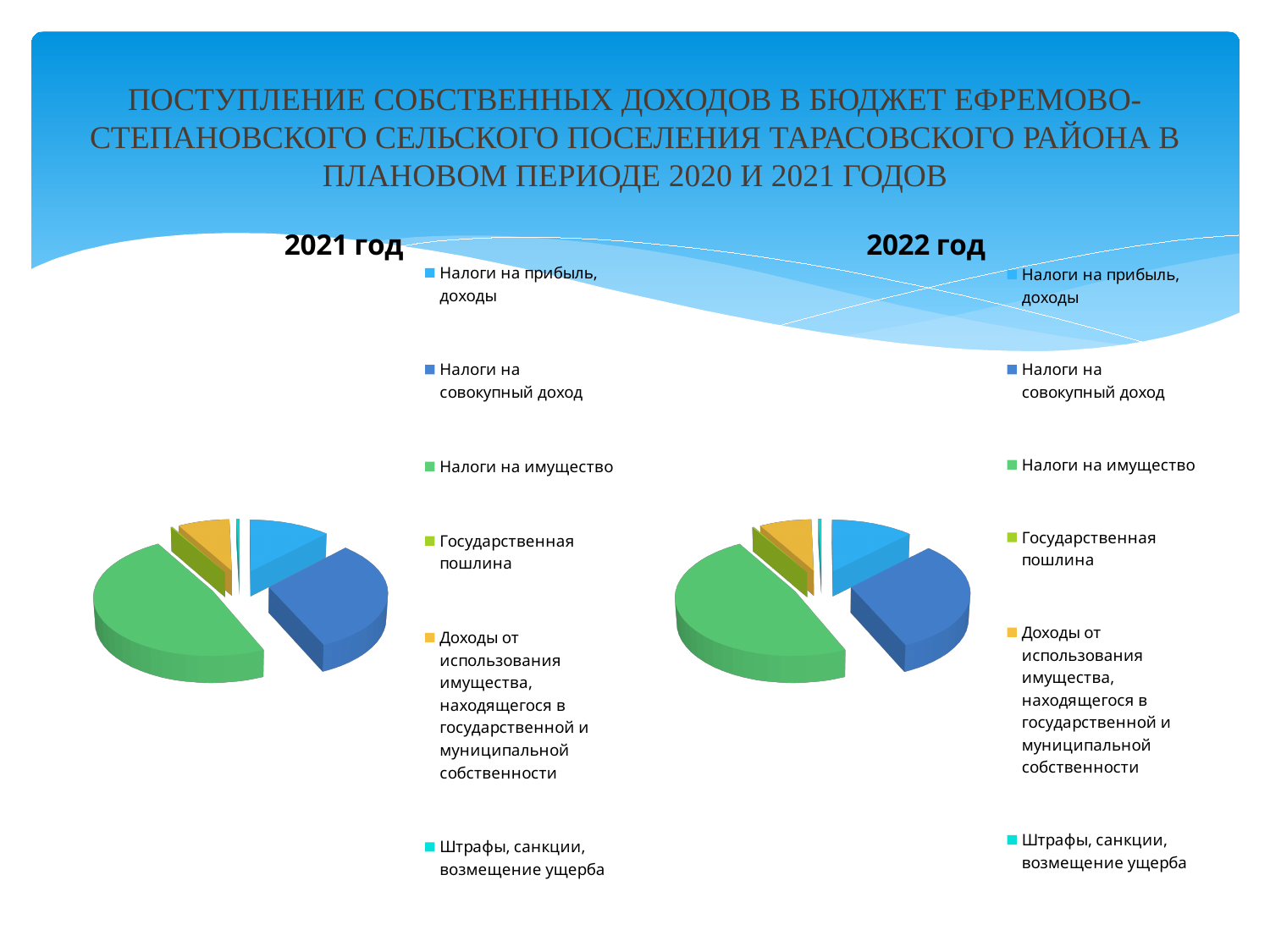
What is the title of the chart on the right side of the slide? 2022 год How many categories does the legend of the "2021 год" chart list? 6 What colour represents "Налоги на имущество" in the "2021 год" chart? green What kind of chart is the "2022 год" chart? pie chart In the "2021 год" chart, which slice is larger: "Налоги на совокупный доход" or "Налоги на прибыль, доходы"? Налоги на совокупный доход In the "2022 год" chart, which category has the largest slice? Налоги на имущество In the "2021 год" chart, which slice is larger: "Налоги на совокупный доход" or "Доходы от использования имущества, находящегося в государственной и муниципальной собственности"? Налоги на совокупный доход What kind of chart is the "2021 год" chart? pie chart In the "2022 год" chart, which slice is larger: "Налоги на прибыль, доходы" or "Государственная пошлина"? Налоги на прибыль, доходы How many categories does the legend of the "2022 год" chart list? 6 In the "2021 год" chart, which category has the largest slice? Налоги на имущество